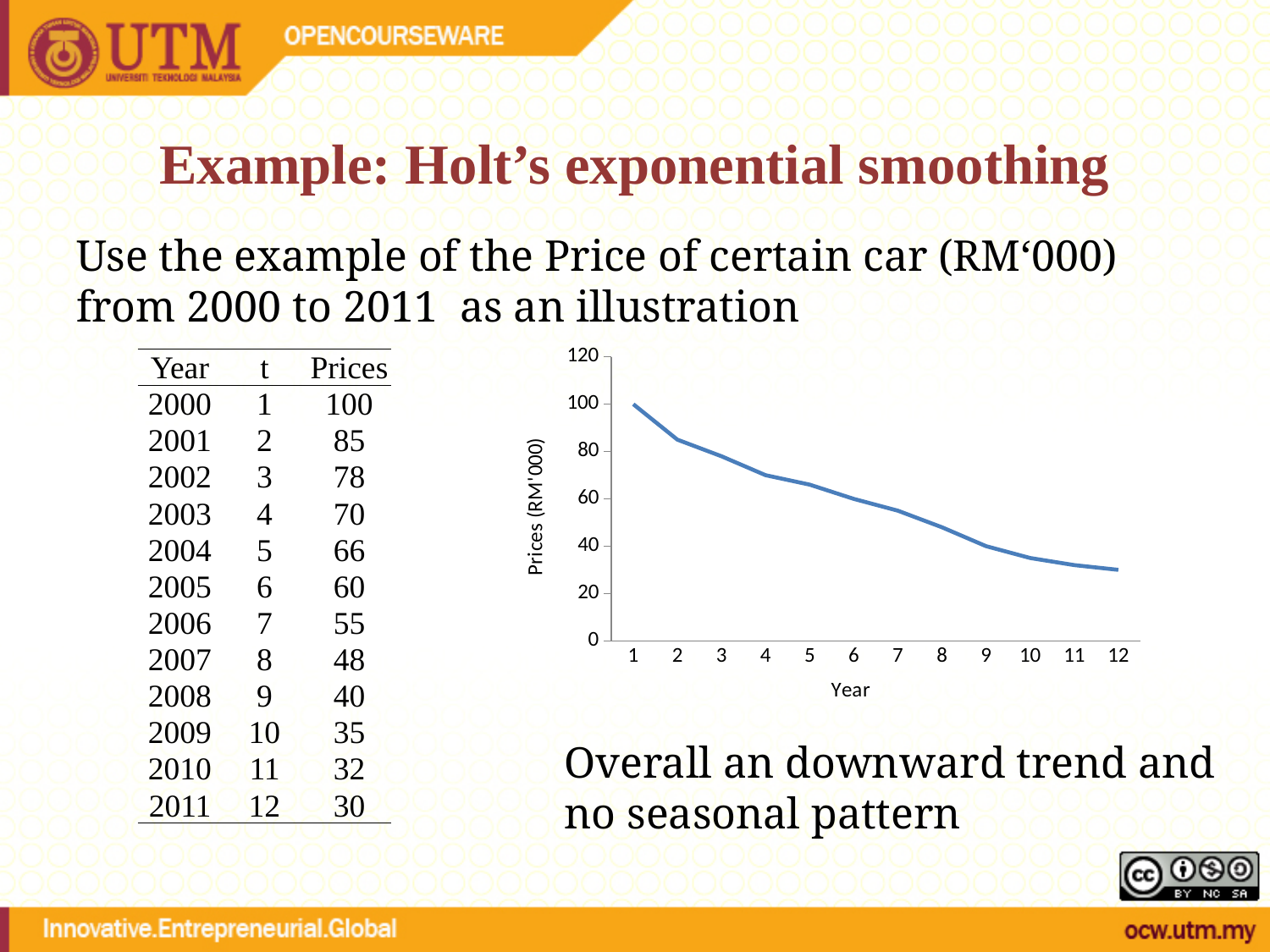
What is the price (RM'000) at year 9 on the chart? 40 What is the label of the y axis on the chart? Prices (RM'000) How many years (data points) are plotted on the chart? 12 Is the price at year 3 greater or less than 80? less Which year has the highest price on the chart? 1 What is the price (RM'000) at year 6 on the chart? 60 What is the price (RM'000) at year 12 on the chart? 30 Do prices rise or fall as the year increases along the x axis? fall Is the price at year 8 greater or less than 40? greater Which year has the lowest price on the chart? 12 What is the price (RM'000) at year 1 on the chart? 100 What kind of chart is shown on the slide? line chart